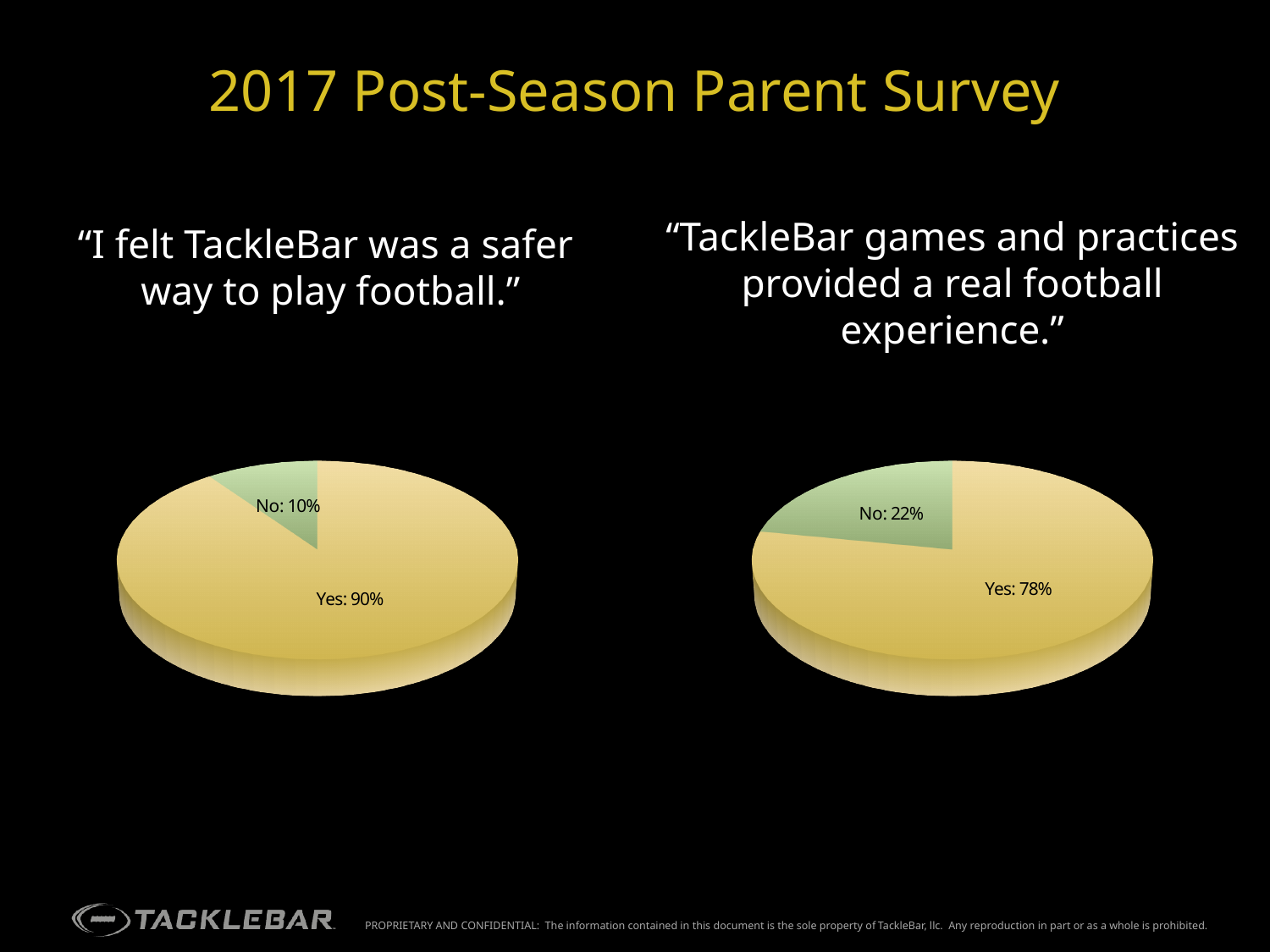
What type of chart is used on the left side of the slide? Pie chart In the right pie chart, which response has the smaller share? No In the left pie chart, what is the difference between the Yes and No percentages? 80% In the right pie chart, what is the difference between the Yes and No percentages? 56% Is the Yes share larger in the left pie chart or the right pie chart? Left pie chart How many slices does the right pie chart have? 2 In the left pie chart, which response has the larger share? Yes In the right pie chart ("TackleBar games and practices provided a real football experience."), what percentage answered No? 22% In the right pie chart ("TackleBar games and practices provided a real football experience."), what percentage answered Yes? 78% What is the title of the slide containing the two pie charts? 2017 Post-Season Parent Survey In the left pie chart ("I felt TackleBar was a safer way to play football."), what percentage answered Yes? 90% In the left pie chart ("I felt TackleBar was a safer way to play football."), what percentage answered No? 10%